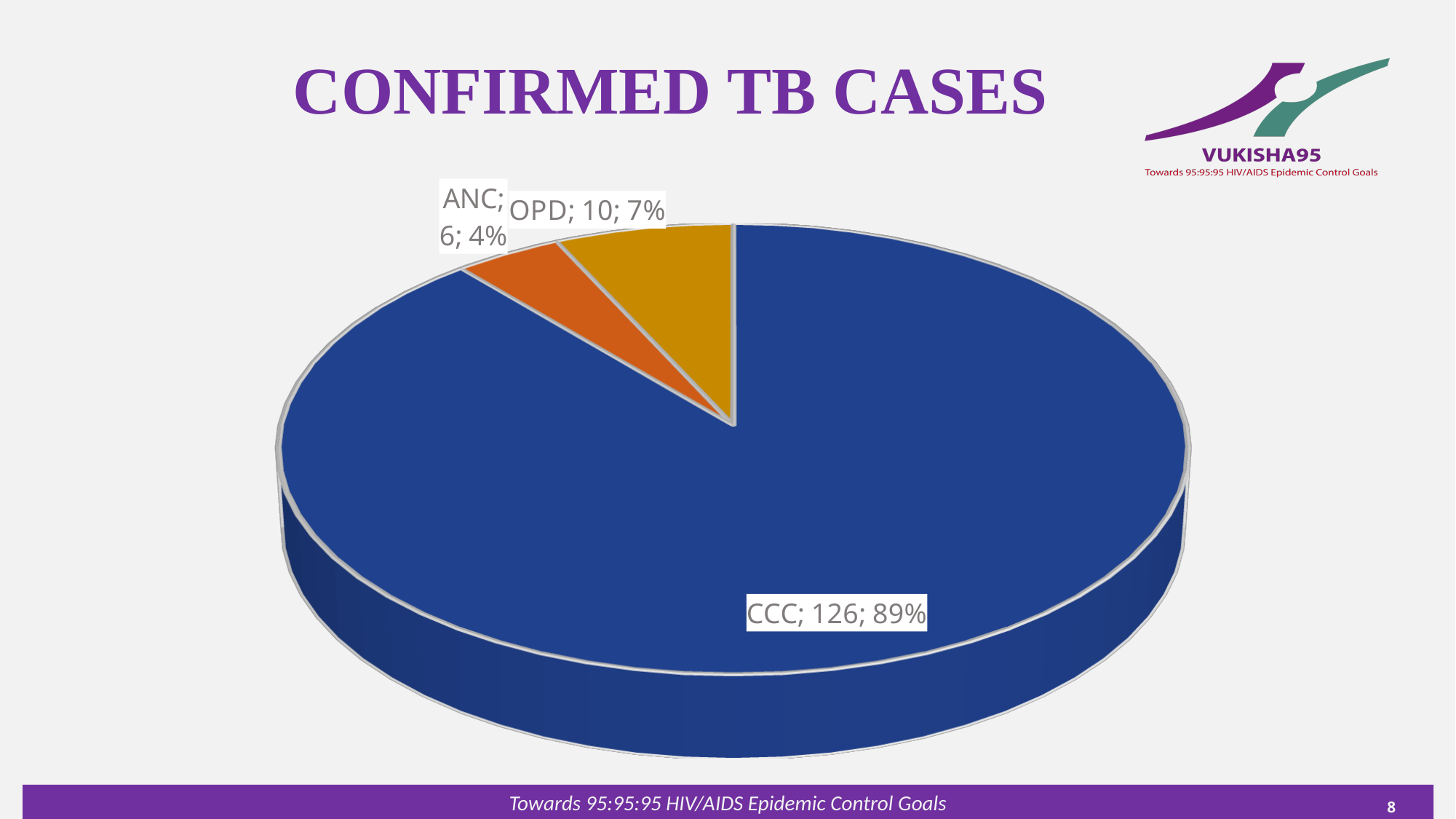
How many confirmed TB cases are from OPD? 10 What percentage share of confirmed TB cases does ANC account for? 4% How many confirmed TB cases are from ANC? 6 What type of chart is shown on the slide? Pie chart Which has more confirmed TB cases, OPD or ANC? OPD How many categories are shown in the pie chart? 3 What percentage share of confirmed TB cases does CCC account for? 89% Which category has the smallest number of confirmed TB cases? ANC What is the difference in confirmed TB cases between CCC and OPD? 116 How many confirmed TB cases are from CCC? 126 Which category has the largest number of confirmed TB cases? CCC What percentage share of confirmed TB cases does OPD account for? 7%